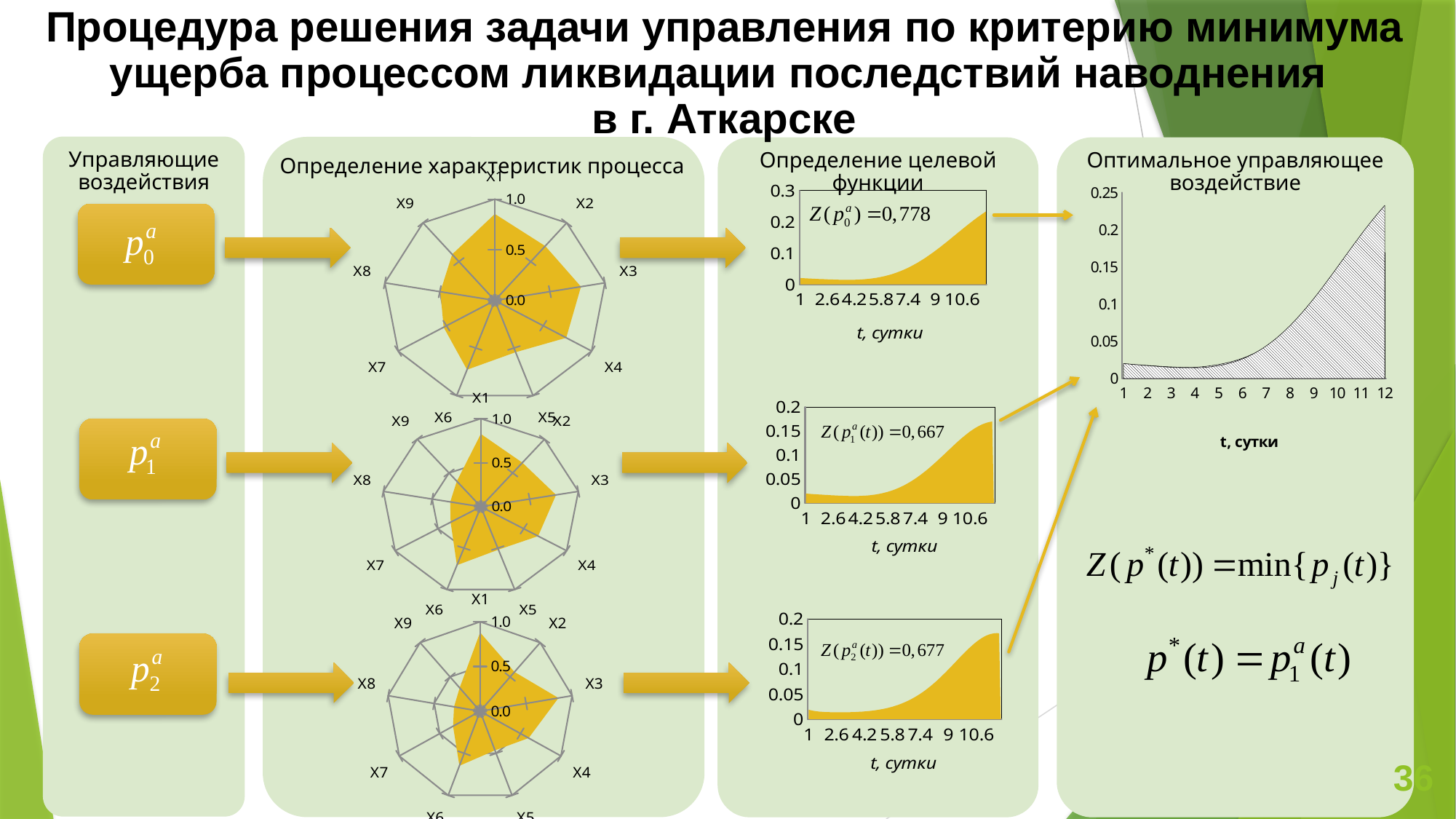
In the top chart of the 'Определение целевой функции' column, what value of Z is printed for p0? 0,778 How many axes (categories X1–X9) does the top radar chart in the 'Определение характеристик процесса' column have? 9 What is the maximum radial tick value shown on the radar charts in the 'Определение характеристик процесса' column? 1.0 In the 'Оптимальное управляющее воздействие' chart, how many tick marks are labelled on the t axis? 12 What is the difference between the Z value printed for p0 (0,778) and the Z value printed for p1(t) (0,667) in the 'Определение целевой функции' column? 0,111 In the bottom chart of the 'Определение целевой функции' column, what value of Z is printed for p2(t)? 0,677 Among the three Z values printed in the 'Определение целевой функции' column, which control action has the lowest Z? p1 What kind of chart is used in the 'Определение характеристик процесса' column to show the process characteristics X1–X9? radar chart In the middle chart of the 'Определение целевой функции' column, what value of Z is printed for p1(t)? 0,667 In the top chart of the 'Определение целевой функции' column, do the values rise or fall as t increases? rise In the 'Оптимальное управляющее воздействие' chart, is the value at t = 12 greater or less than 0.2? greater